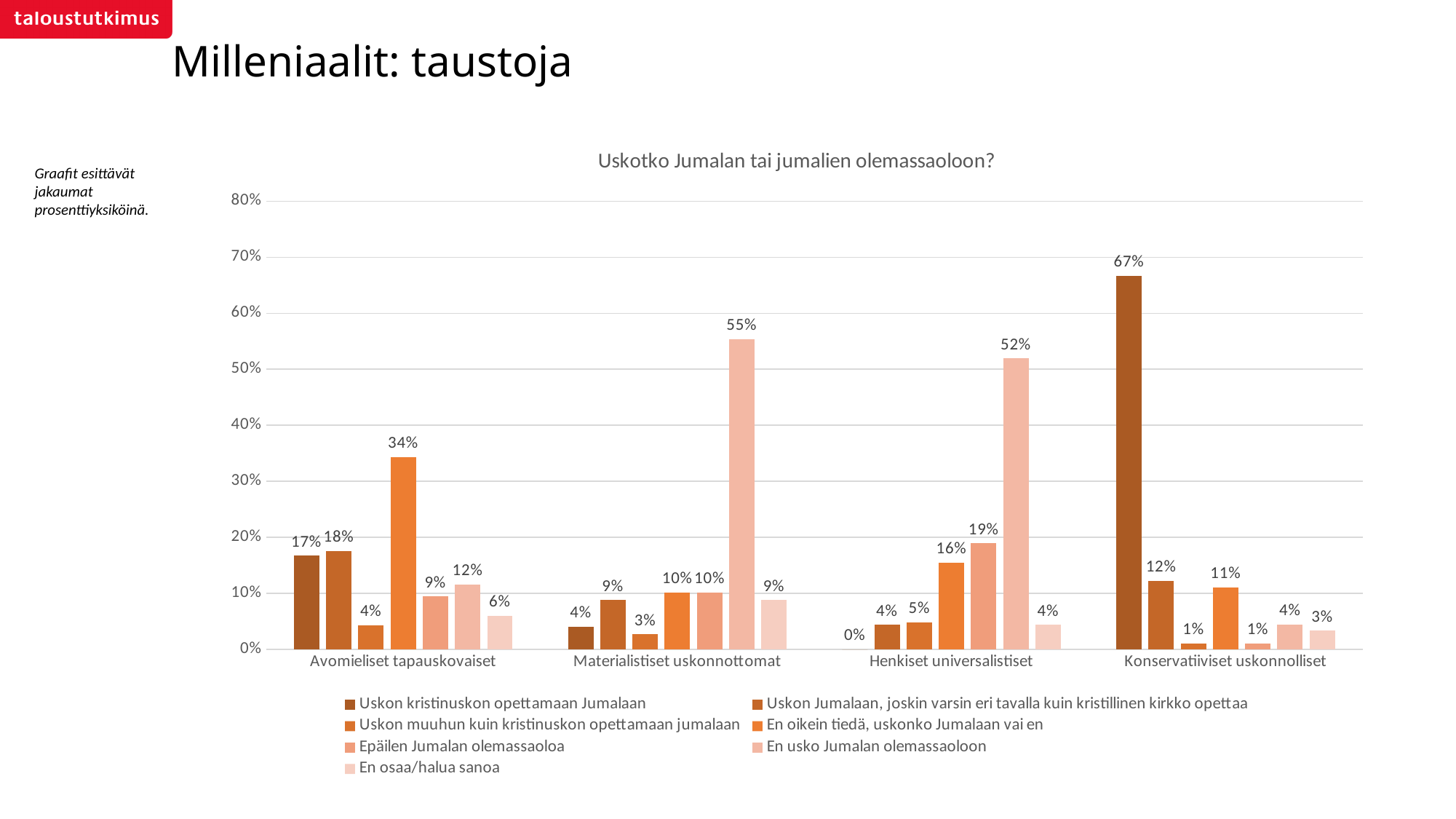
What is the value for 'En oikein tiedä, uskonko Jumalaan vai en' in the 'Avomieliset tapauskovaiset' category? 34% Which category has the lowest value for 'Uskon kristinuskon opettamaan Jumalaan'? Henkiset universalistiset What is the value for 'Uskon kristinuskon opettamaan Jumalaan' in the 'Henkiset universalistiset' category? 0% Which category has the highest value for 'En usko Jumalan olemassaoloon'? Materialistiset uskonnottomat How many series does the legend list? 7 How many categories are shown on the x axis? 4 What is the title of the chart? Uskotko Jumalan tai jumalien olemassaoloon? What is the value for 'En usko Jumalan olemassaoloon' in the 'Materialistiset uskonnottomat' category? 55% What kind of chart is shown on the slide? Bar chart Which is larger: 'Epäilen Jumalan olemassaoloa' for 'Henkiset universalistiset' or for 'Avomieliset tapauskovaiset'? Henkiset universalistiset What is the value for 'Uskon kristinuskon opettamaan Jumalaan' in the 'Konservatiiviset uskonnolliset' category? 67% What is the difference between 'En usko Jumalan olemassaoloon' for 'Materialistiset uskonnottomat' and for 'Henkiset universalistiset'? 3%